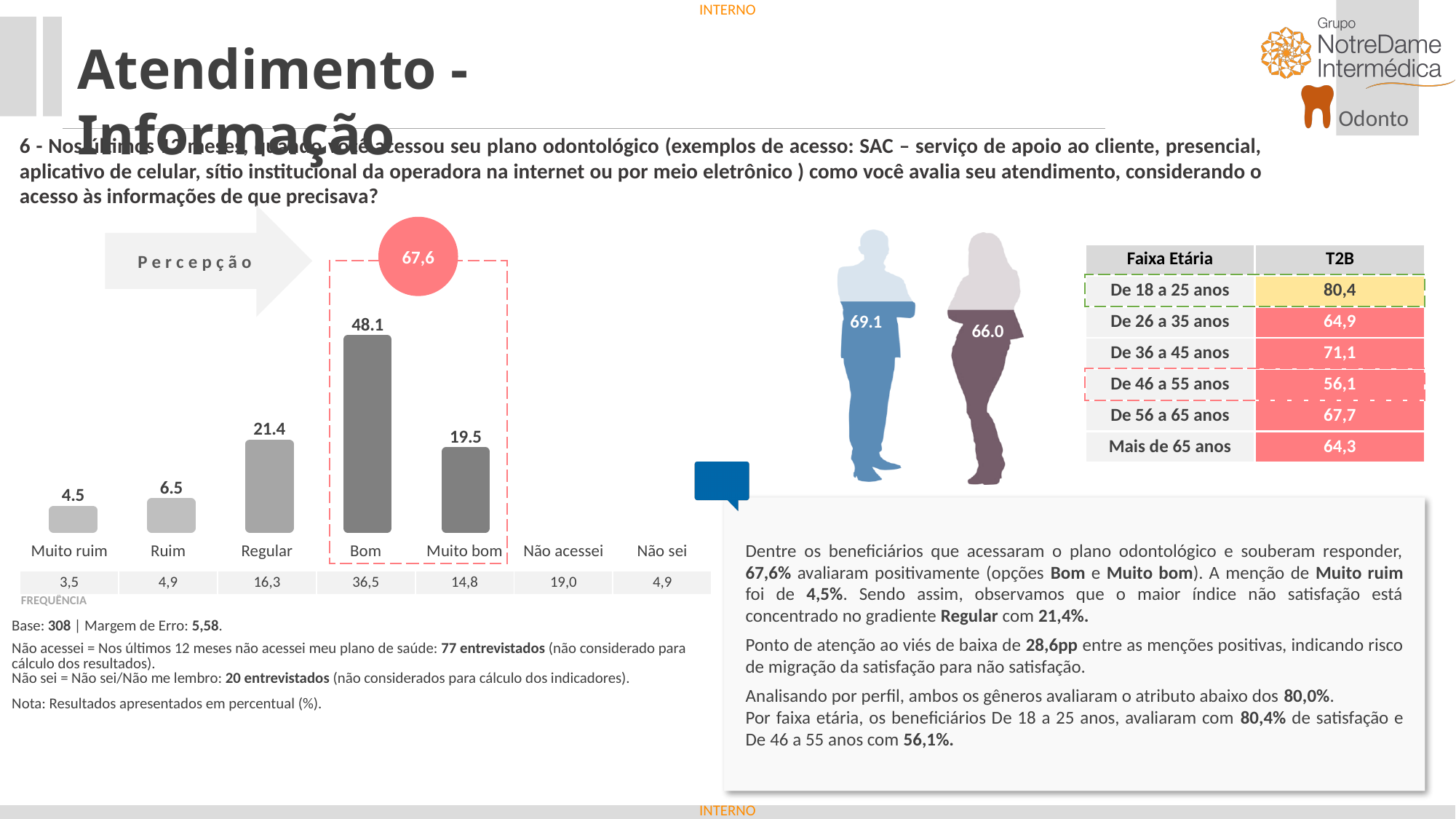
What is the difference between the Bom and Muito bom values in the Percepção chart? 28.6 What is the difference between the Ruim and Muito ruim values in the Percepção chart? 2.0 What is the value shown for the Regular bar in the Percepção chart? 21.4 Which category has the lowest plotted bar in the Percepção chart? Muito ruim What is the combined value of the Bom and Muito bom bars in the Percepção chart? 67.6 What is the value shown for the Bom bar in the Percepção chart? 48.1 What is the value shown for the Muito ruim bar in the Percepção chart? 4.5 How many bars are plotted in the Percepção chart? 5 What value is shown in the red circle above the Bom and Muito bom bars in the Percepção chart? 67,6 Which category has the highest bar in the Percepção chart? Bom What type of chart is the Percepção chart? bar chart Which is larger in the Percepção chart, the value for Regular or the value for Muito bom? Regular